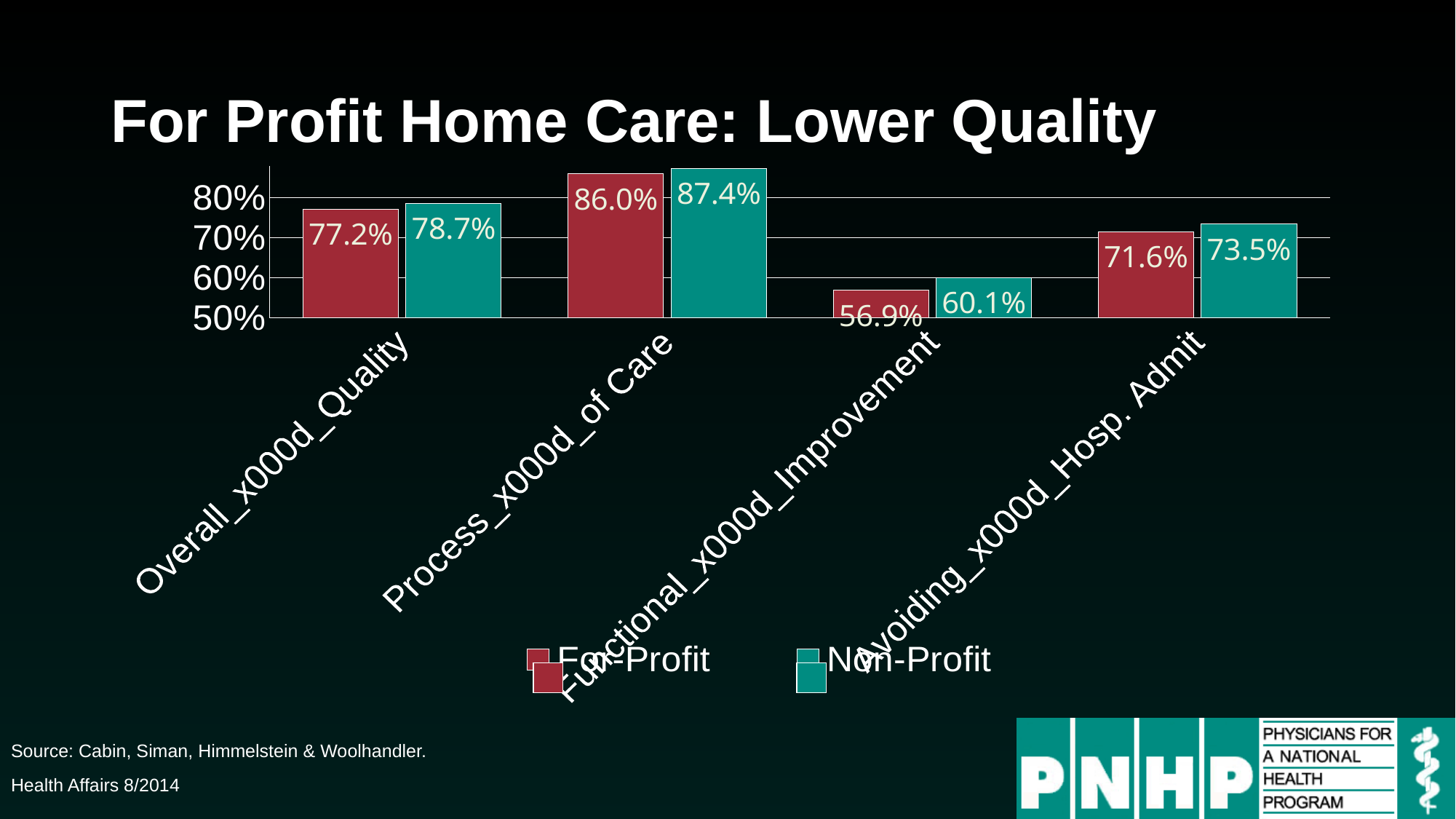
What is the Non-Profit value for Avoiding Hosp. Admit? 73.5% What is the For-Profit value for Overall Quality? 77.2% How many categories are shown on the x axis? 4 Which category has the highest Non-Profit value? Process of Care What colour are the For-Profit bars? Red What is the difference between the Non-Profit and For-Profit values for Functional Improvement? 3.2% Which is larger for Avoiding Hosp. Admit, the For-Profit value or the Non-Profit value? Non-Profit What kind of chart is shown on the slide? Bar chart Which category has the lowest For-Profit value? Functional Improvement What is the For-Profit value for Functional Improvement? 56.9% How many series does the legend list? 2 What is the Non-Profit value for Process of Care? 87.4%